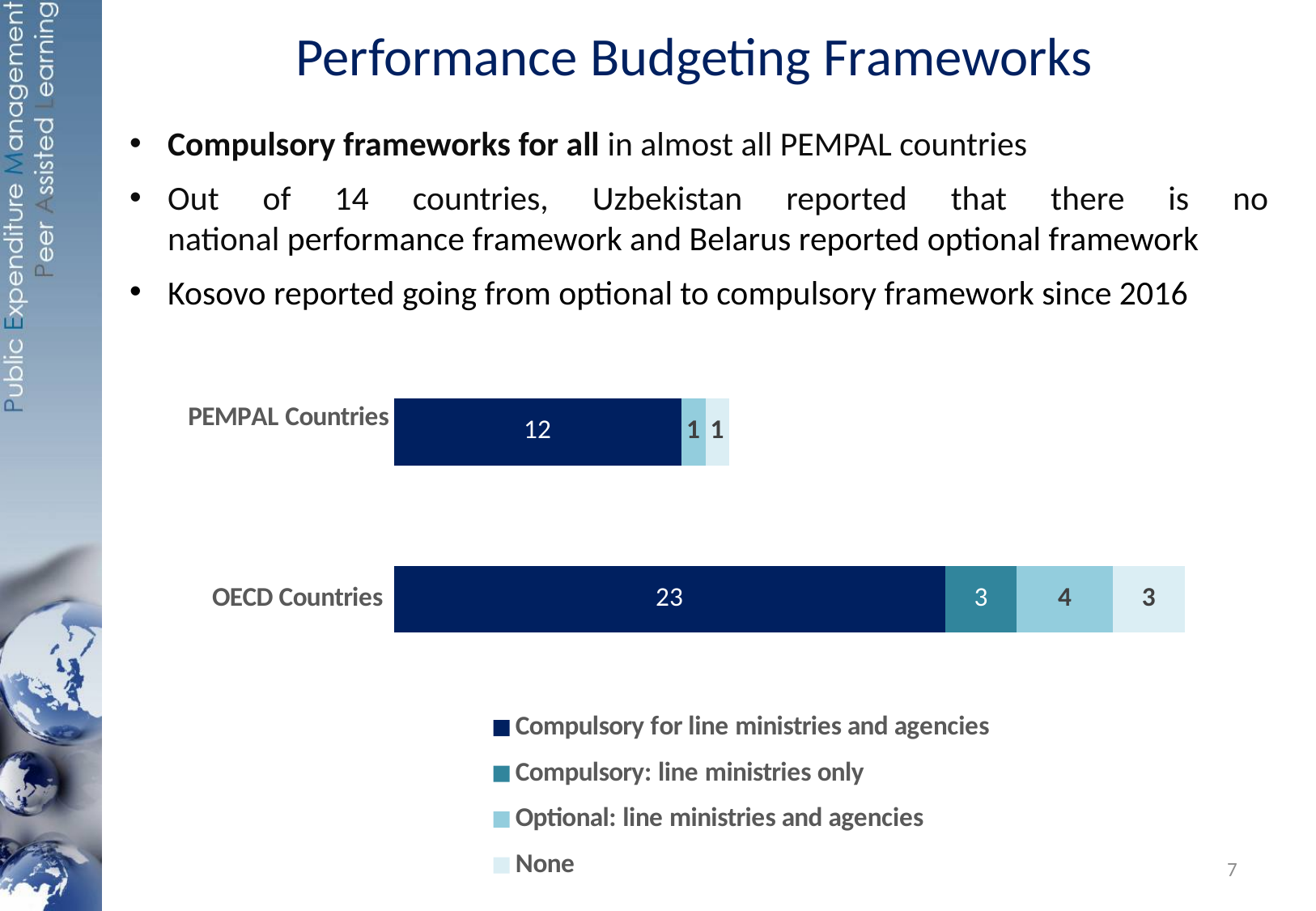
What is the value for None for OECD Countries? 3 What is the value for Compulsory: line ministries only for OECD Countries? 3 What is the total of the stacked bar for OECD Countries? 33 What is the value for Compulsory for line ministries and agencies for OECD Countries? 23 What kind of chart is shown on the slide? Stacked bar chart What is the value for Compulsory for line ministries and agencies for PEMPAL Countries? 12 What is the value for Optional: line ministries and agencies for OECD Countries? 4 How many series does the legend list? 4 What is the difference between the Compulsory for line ministries and agencies values for OECD Countries and PEMPAL Countries? 11 Which category has the larger value for Compulsory for line ministries and agencies, PEMPAL Countries or OECD Countries? OECD Countries What is the total of the stacked bar for PEMPAL Countries? 14 What is the value for None for PEMPAL Countries? 1